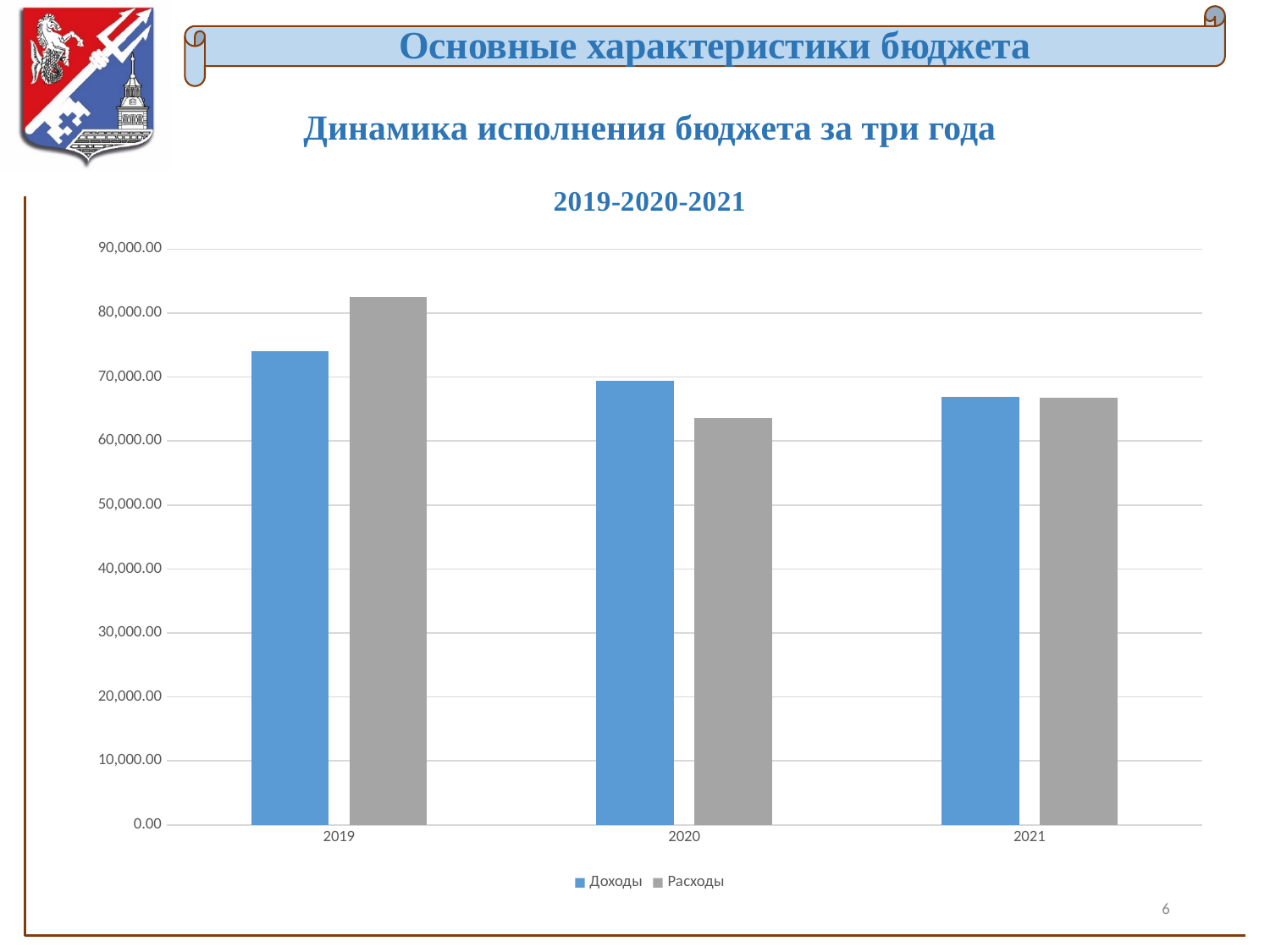
Is the value for Расходы in 2019 greater or less than 80,000.00? greater In 2020, which is larger, Доходы or Расходы? Доходы How many years are shown on the x axis of the chart? 3 In which year is the Расходы bar the highest? 2019 What is the title shown above the chart? 2019-2020-2021 What are the two series named in the chart legend? Доходы and Расходы In which year is the Расходы bar the lowest? 2020 Do the Доходы values rise or fall from 2019 to 2021? fall In 2019, which is larger, Доходы or Расходы? Расходы In which year is the Доходы bar the highest? 2019 How many series does the chart legend list? 2 What kind of chart is shown on the slide? bar chart